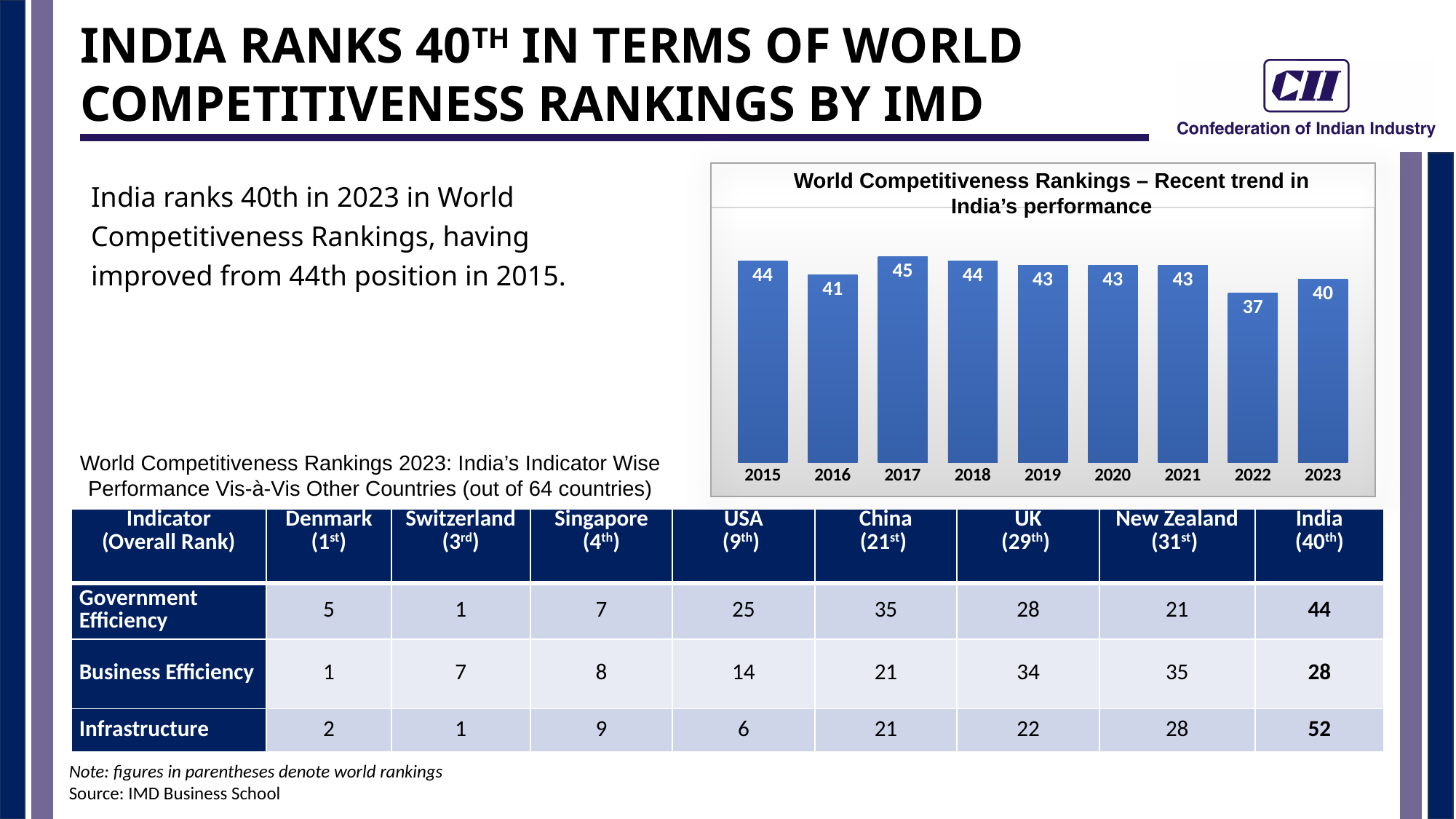
What is India's World Competitiveness Ranking for 2022 in the chart? 37 Do the values in the chart rise or fall from 2021 to 2022? Fall What is the difference between the 2017 value and the 2022 value in the chart? 8 How many years are shown in the World Competitiveness Rankings chart? 9 What is India's World Competitiveness Ranking for 2017 in the chart? 45 What is the title of the chart on the slide? World Competitiveness Rankings – Recent trend in India's performance What is India's World Competitiveness Ranking for 2023 in the chart? 40 What is the difference between the 2015 value and the 2023 value in the chart? 4 Which year has the highest value in the World Competitiveness Rankings chart? 2017 What kind of chart is used to show India's World Competitiveness Rankings trend? Bar chart Which year has the lowest value in the World Competitiveness Rankings chart? 2022 Which is larger in the chart, the value for 2016 or the value for 2018? 2018